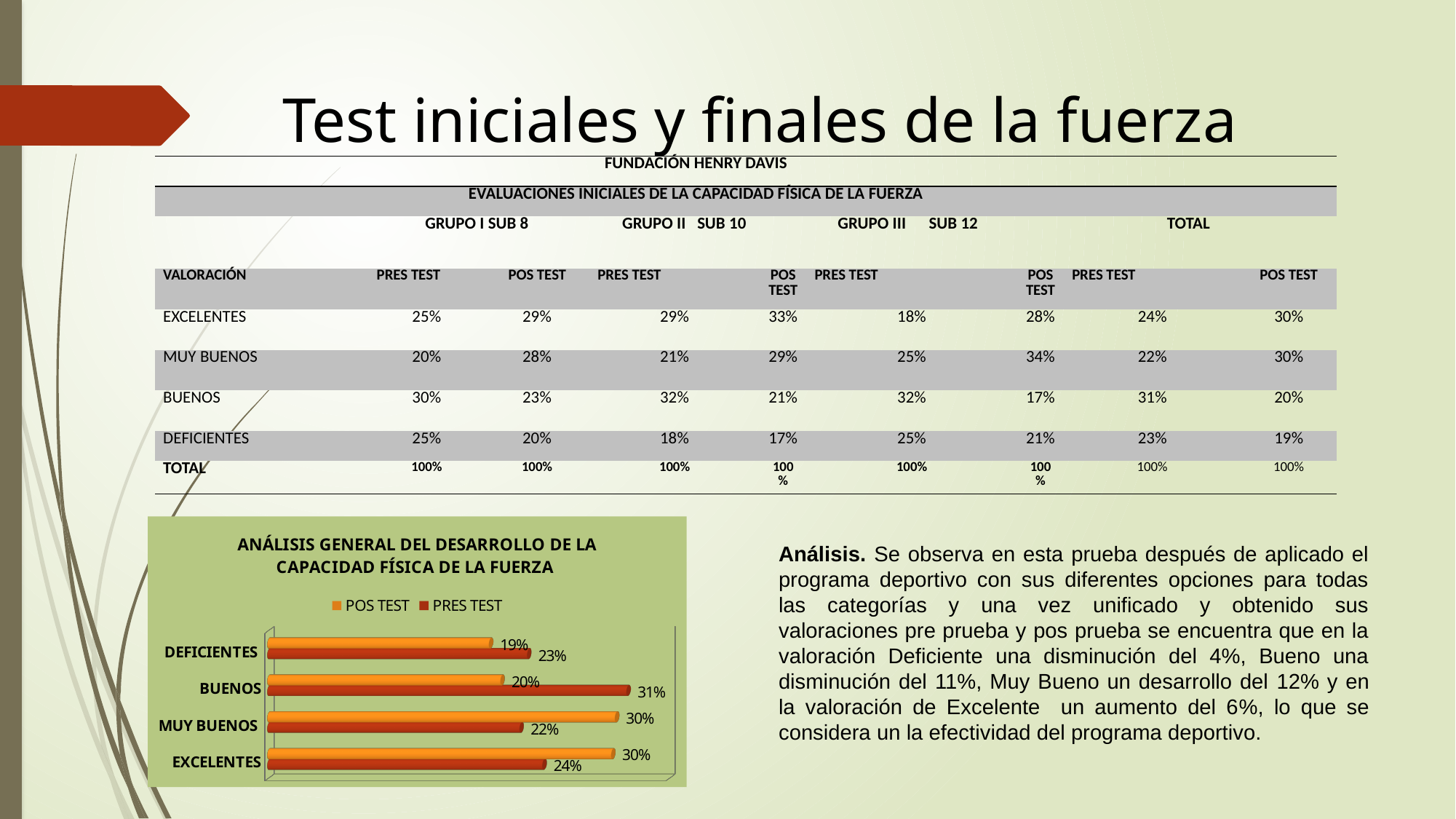
Which category has the lowest POS TEST value in the chart? DEFICIENTES What is the PRES TEST value for EXCELENTES in the chart? 24% For MUY BUENOS, which is larger in the chart: the POS TEST value or the PRES TEST value? POS TEST How many categories are shown on the chart? 4 What is the POS TEST value for DEFICIENTES in the chart? 19% What type of chart is shown on the slide? bar chart What is the PRES TEST value for BUENOS in the chart? 31% What is the title of the chart on the slide? ANÁLISIS GENERAL DEL DESARROLLO DE LA CAPACIDAD FÍSICA DE LA FUERZA What is the difference between the PRES TEST and POS TEST values for BUENOS in the chart? 11% What is the POS TEST value for MUY BUENOS in the chart? 30% How many series does the chart legend list? 2 Which category has the highest PRES TEST value in the chart? BUENOS